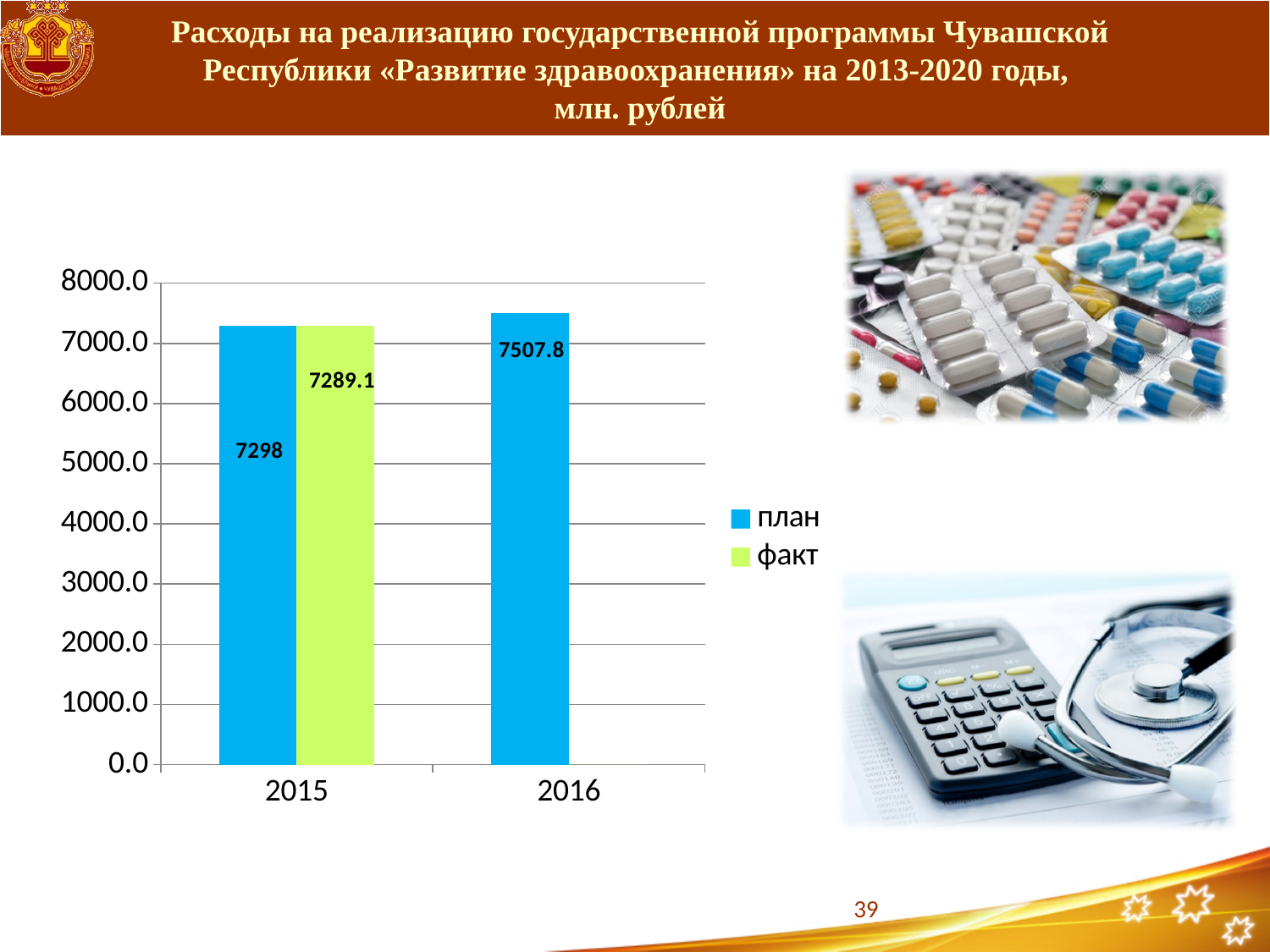
What kind of chart is shown on the slide? bar chart How many series does the legend list? 2 Does the план value rise or fall from 2015 to 2016? rise How many years are shown on the x axis of the chart? 2 What is the value of the план bar for 2016? 7507.8 Is the факт value for 2015 greater or less than 8000.0? less Is the план value for 2016 greater or less than 7000.0? greater What is the difference between the план and факт values for 2015? 8.9 What is the value of the факт bar for 2015? 7289.1 What is the value of the план bar for 2015? 7298 What is the difference between the план values for 2016 and 2015? 209.8 Which year has the higher план value, 2015 or 2016? 2016